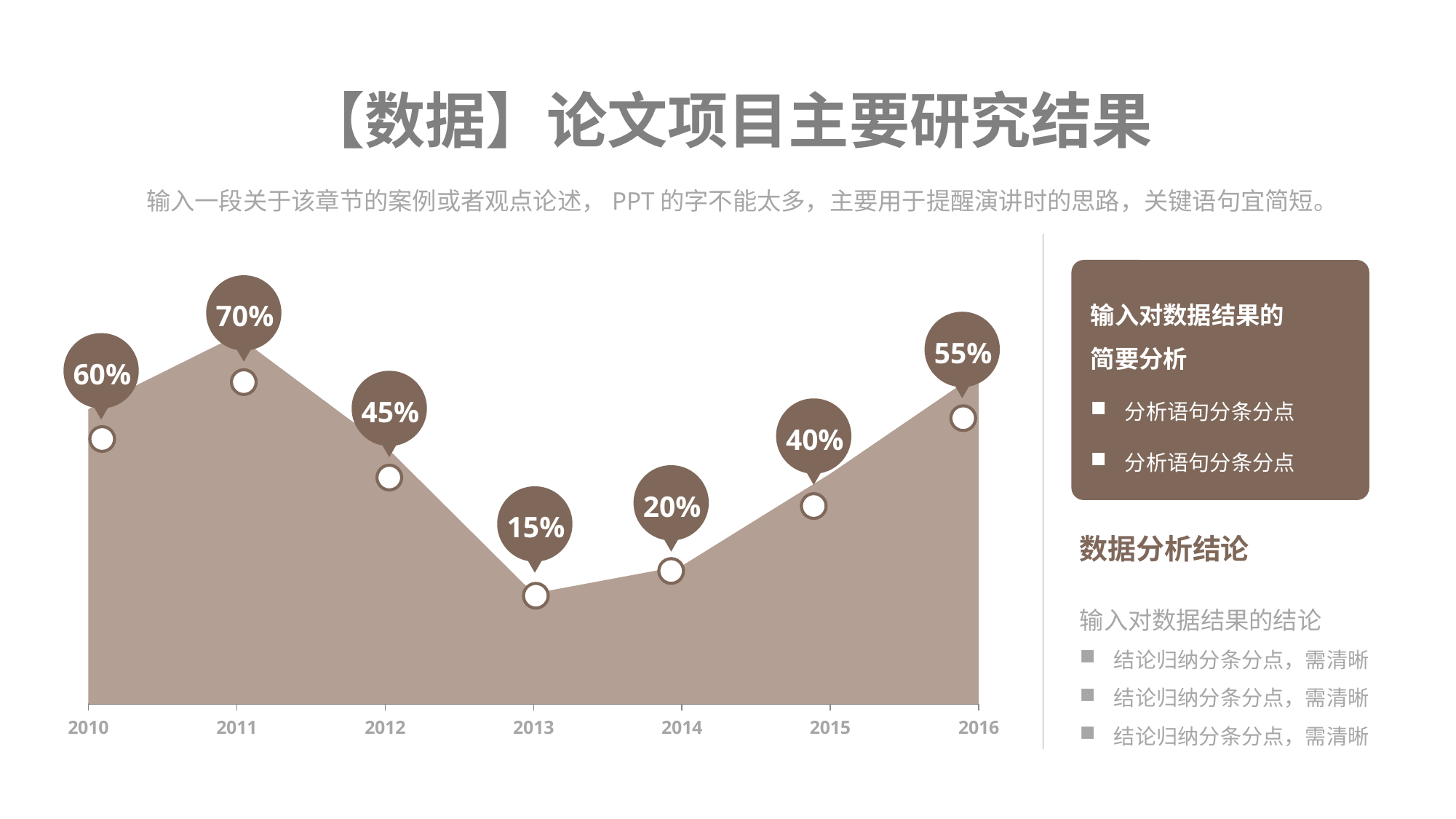
What is the value for 2013? 15% Do the values rise or fall from 2013 to 2016? Rise What is the value for 2010? 60% Which year has the lowest value? 2013 Which year has the highest value? 2011 What is the value for 2016? 55% What is the difference between the values for 2011 and 2013? 55% What is the difference between the values for 2015 and 2014? 20% How many years are plotted on the x axis? 7 Do the values rise or fall from 2011 to 2013? Fall What kind of chart is shown on the slide? Area chart Which is larger, the value for 2012 or the value for 2016? 2016